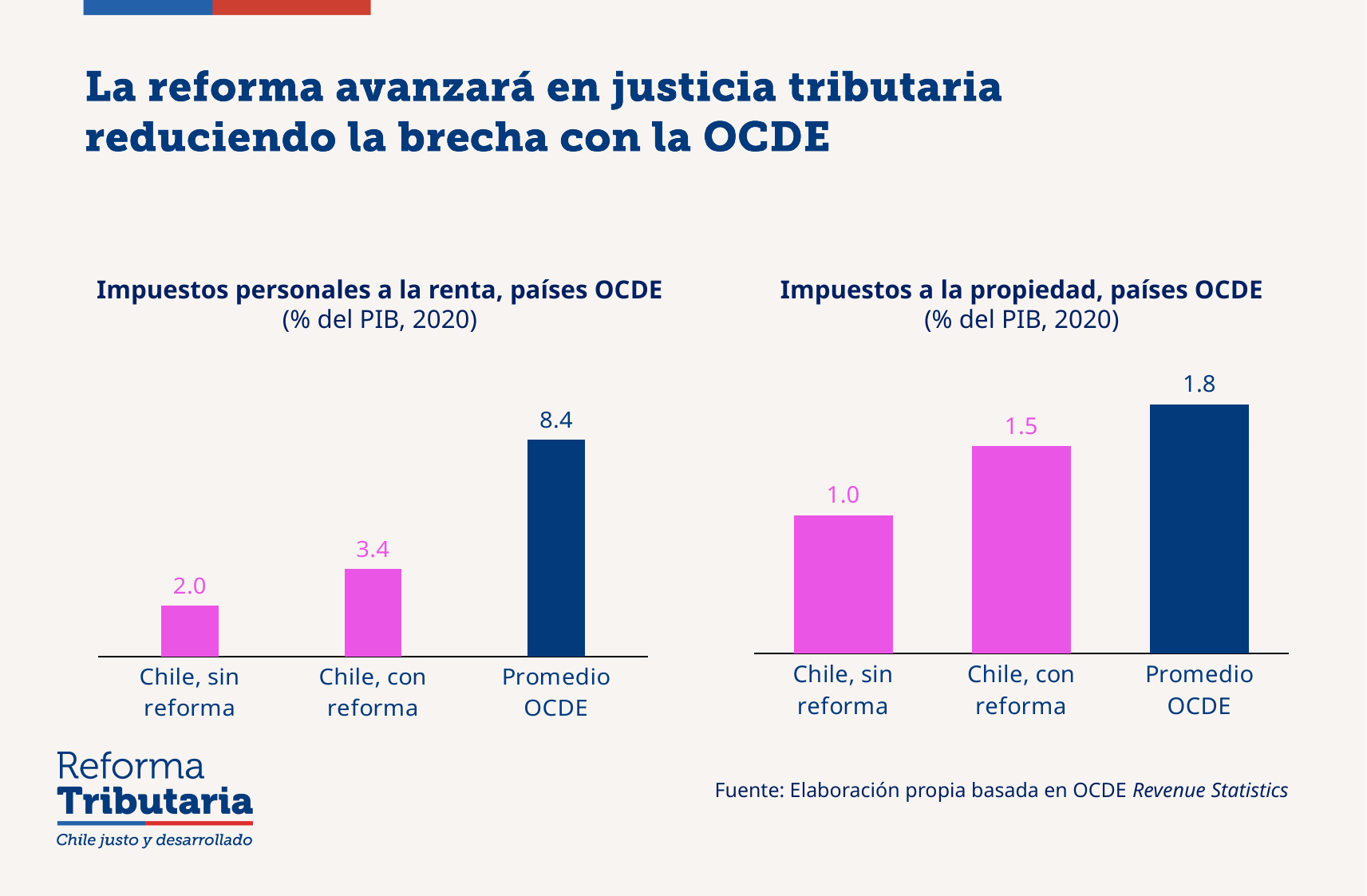
How many categories does the chart 'Impuestos personales a la renta, países OCDE' show? 3 In the chart 'Impuestos personales a la renta, países OCDE', what is the value for 'Chile, sin reforma'? 2.0 In the chart 'Impuestos a la propiedad, países OCDE', which is larger: 'Chile, con reforma' or 'Promedio OCDE'? Promedio OCDE In the chart 'Impuestos a la propiedad, países OCDE', what is the value for 'Chile, con reforma'? 1.5 In the chart 'Impuestos personales a la renta, países OCDE', which category has the highest value? Promedio OCDE In the chart 'Impuestos personales a la renta, países OCDE', what is the difference between 'Promedio OCDE' and 'Chile, con reforma'? 5.0 In the chart 'Impuestos a la propiedad, países OCDE', what is the difference between 'Chile, con reforma' and 'Chile, sin reforma'? 0.5 In the chart 'Impuestos a la propiedad, países OCDE', which category has the lowest value? Chile, sin reforma In the chart 'Impuestos personales a la renta, países OCDE', what is the value for 'Chile, con reforma'? 3.4 What kind of chart is 'Impuestos a la propiedad, países OCDE'? Bar chart In the chart 'Impuestos personales a la renta, países OCDE', what is the value for 'Promedio OCDE'? 8.4 In the chart 'Impuestos a la propiedad, países OCDE', what is the value for 'Promedio OCDE'? 1.8